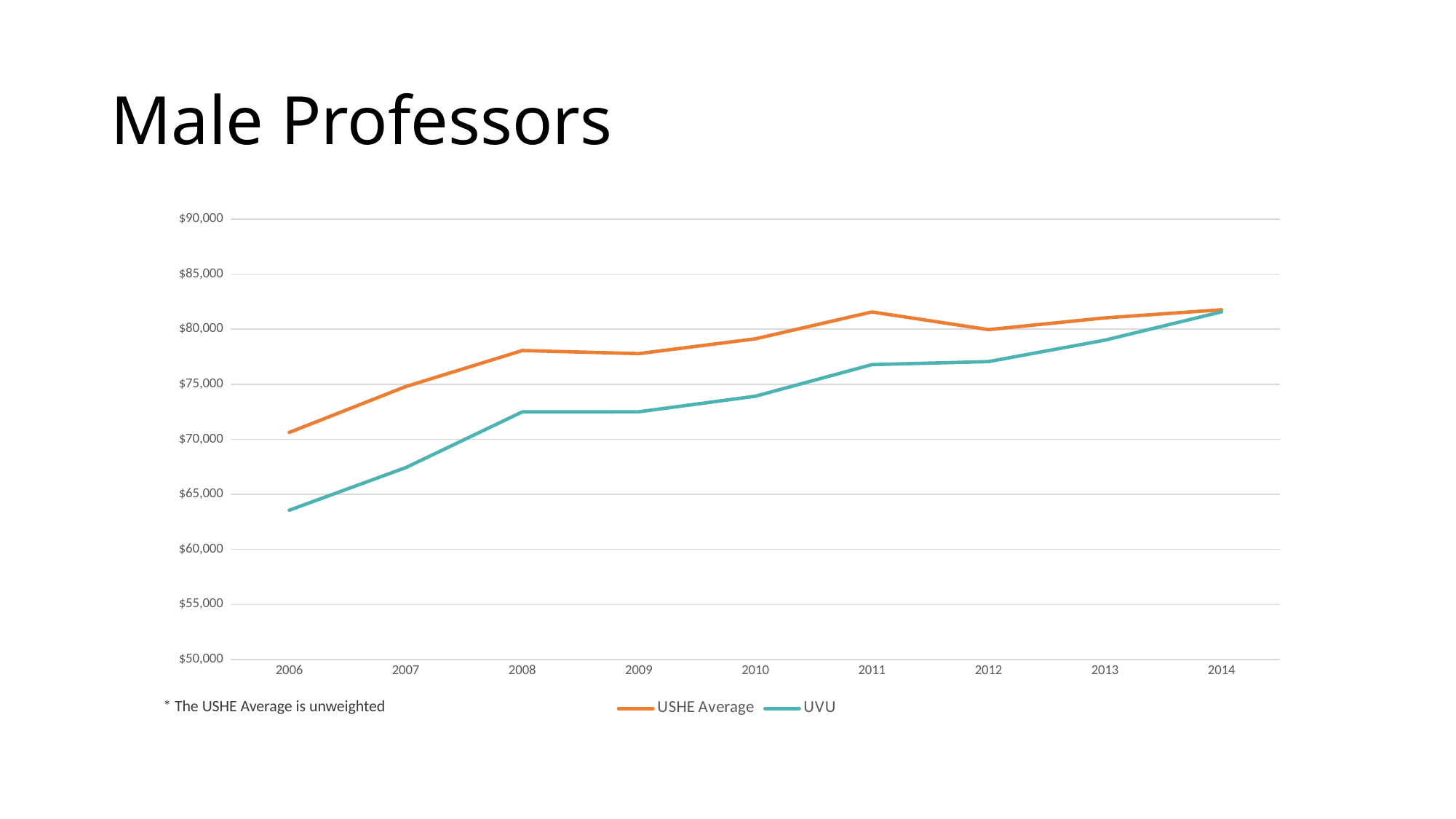
Is the USHE Average value for 2011 greater or less than $80,000? greater How many series does the legend list? 2 What kind of chart is shown on the slide? Line chart What does the footnote below the chart say about the USHE Average? The USHE Average is unweighted In which year is the UVU value highest? 2014 Is the UVU value for 2008 greater or less than $70,000? greater In which year is the UVU value lowest? 2006 Is the UVU value for 2010 greater or less than $75,000? less Does the UVU line generally rise or fall from 2006 to 2014? Rise In 2006, which series has the higher value, USHE Average or UVU? USHE Average How many years are plotted along the x axis? 9